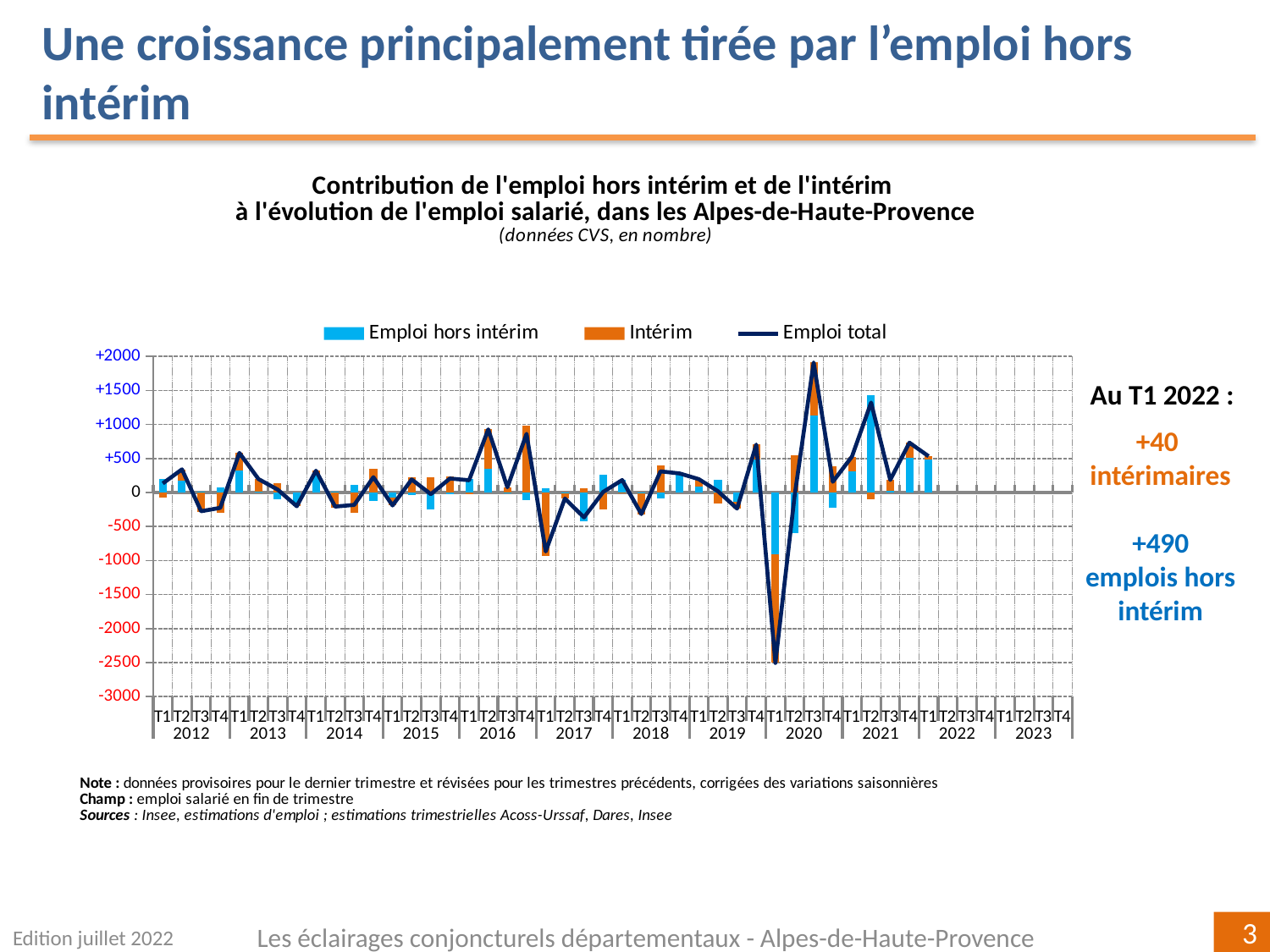
What is the difference between the Emploi hors intérim value (+490) and the Intérim value (+40) at T1 2022? 450 Is the Emploi total value at T3 2020 greater or less than +1500? greater In which quarter does the Emploi total line reach its lowest point? T1 2020 Is the Emploi total value at T1 2020 greater or less than -2000? less What is the total of the Emploi hors intérim and Intérim contributions at T1 2022? +530 How many series does the legend list? 3 What kind of chart is shown on the slide? A combined bar and line chart At T1 2022, which is larger: Emploi hors intérim or Intérim? Emploi hors intérim According to the slide, what is the value for Intérim at T1 2022? +40 What are the three series named in the legend? Emploi hors intérim, Intérim, Emploi total In which quarter does the Emploi total line reach its highest point? T3 2020 According to the slide, what is the value for Emploi hors intérim at T1 2022? +490